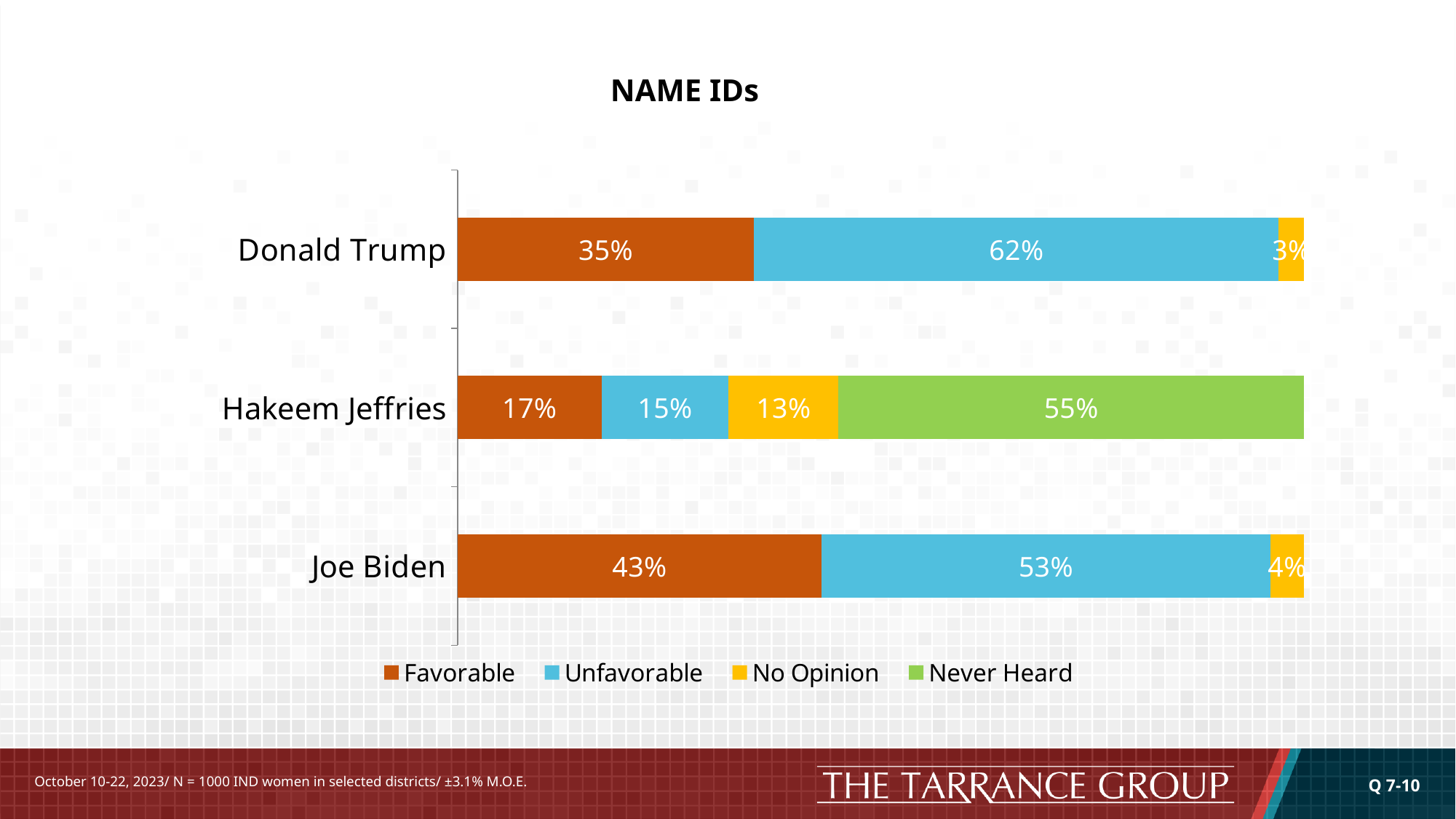
Which person has the lowest Unfavorable value? Hakeem Jeffries What is the difference between Donald Trump's Unfavorable and Favorable values? 27% Which person has the highest Favorable value? Joe Biden How many series does the legend list? 4 What is the No Opinion value for Hakeem Jeffries? 13% How many people are shown on the chart? 3 What is the title of the chart? NAME IDs What is the Favorable value for Donald Trump? 35% What is the Unfavorable value for Joe Biden? 53% What is the Never Heard value for Hakeem Jeffries? 55% Is the Favorable value larger for Joe Biden or Donald Trump? Joe Biden What kind of chart is shown? Stacked bar chart